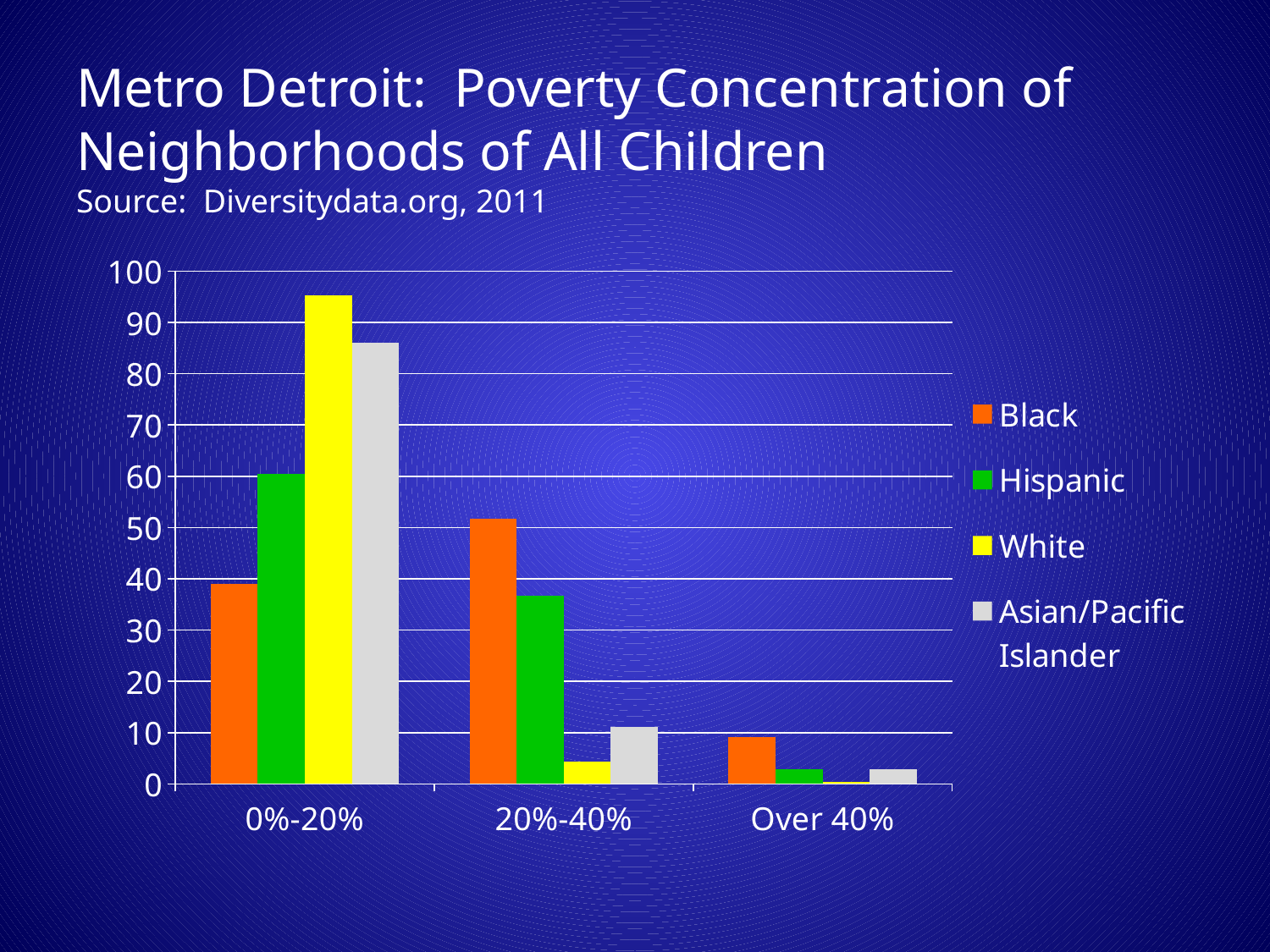
How many series does the legend list? 4 In the 20%-40% category, which group has the lowest bar? White How many poverty concentration categories are shown on the x axis? 3 In the 0%-20% category, which group has the highest bar? White Is the value for White in the 0%-20% category greater or less than 90? greater In the Over 40% category, which group has the highest bar? Black In the 20%-40% category, which is larger: the Black bar or the Hispanic bar? Black In the 20%-40% category, which group has the highest bar? Black Do the values for the White series rise or fall moving from 0%-20% to Over 40%? fall In the 0%-20% category, which group has the lowest bar? Black What kind of chart is shown on the slide? bar chart Is the value for Black in the 0%-20% category greater or less than 50? less